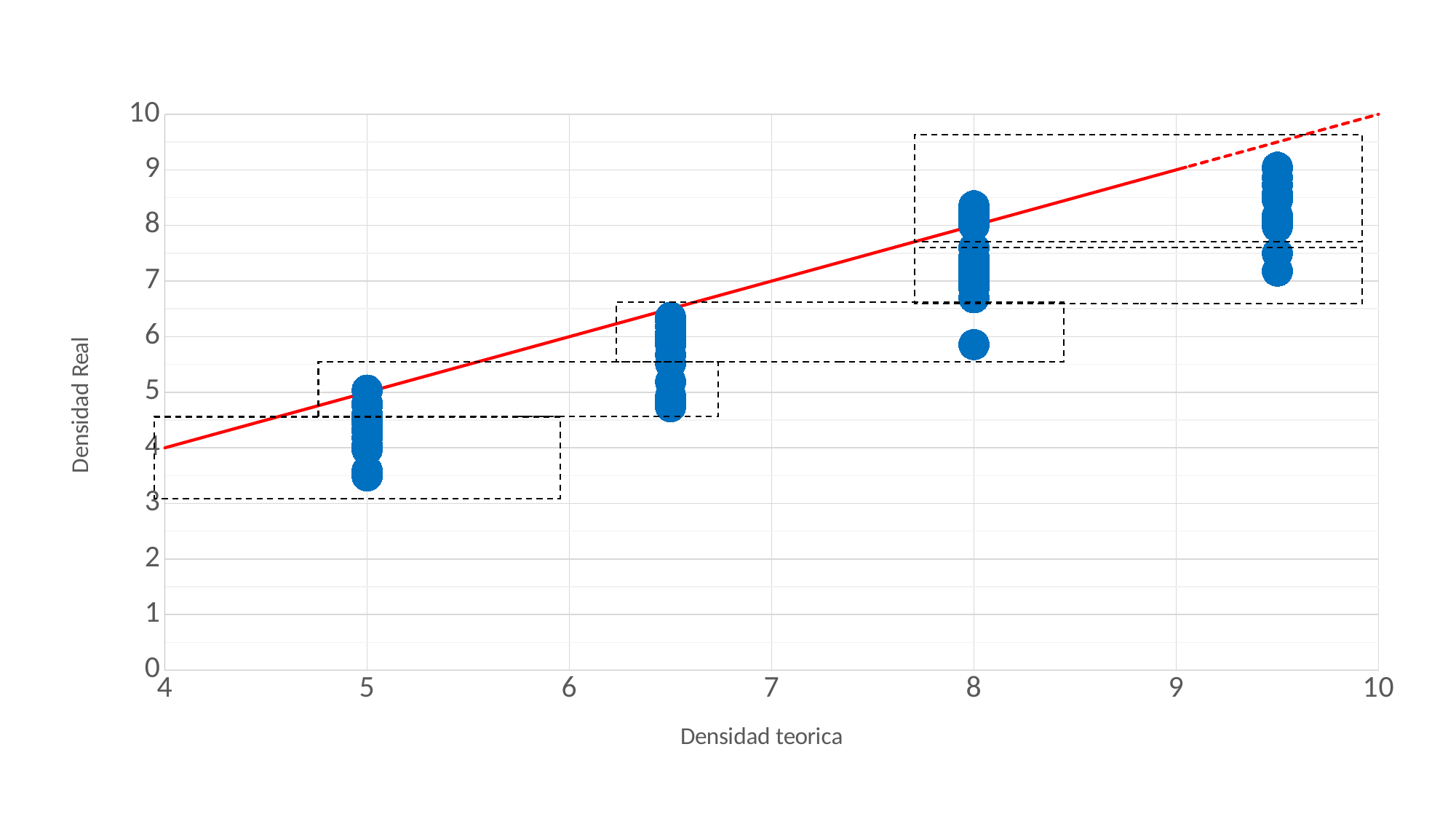
What is the title of the vertical axis? Densidad Real What kind of chart is shown on the slide? scatter chart Is the lowest blue point in the cluster at Densidad teorica 6.5 greater or less than 4 on the Densidad Real axis? greater What is the title of the horizontal axis? Densidad teorica What is the maximum value shown on the Densidad Real axis? 10 Is the highest blue point in the cluster at Densidad teorica 9.5 greater or less than 8 on the Densidad Real axis? greater Which cluster of blue points reaches the highest Densidad Real value: the one at Densidad teorica 5 or the one at 9.5? 9.5 Do the blue data points generally rise or fall as Densidad teorica increases along the x axis? rise Is the highest blue point in the cluster at Densidad teorica 6.5 greater or less than 7 on the Densidad Real axis? less At how many distinct x-axis positions are the blue data points clustered? 4